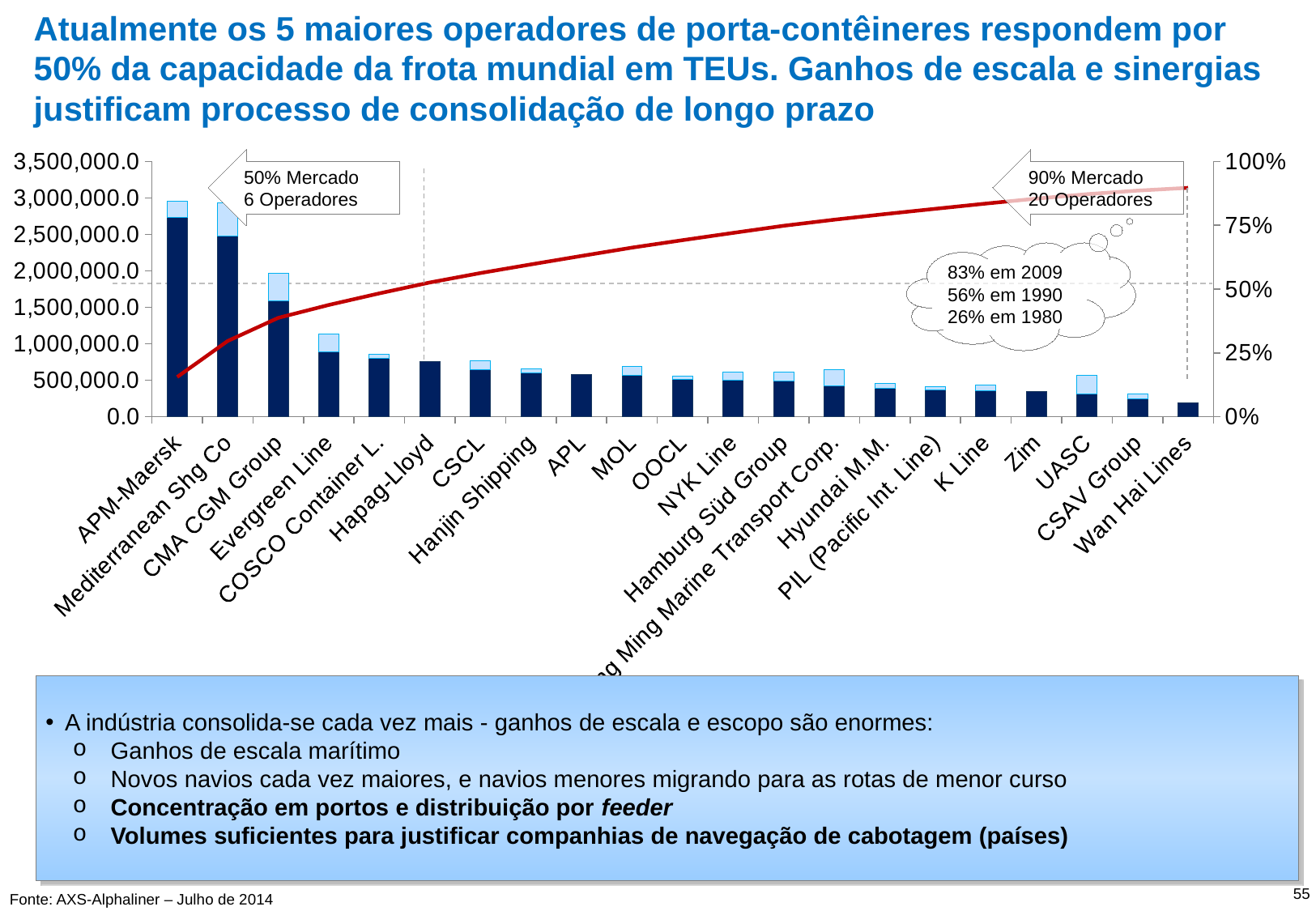
Does the red line rise or fall from left to right across the chart? Rises Which operator has the tallest bar in the chart? APM-Maersk How many operators are shown on the x axis of the chart? 21 Is the bar for APM-Maersk greater or less than 2,500,000.0? greater According to the annotation on the chart, how many operators account for 50% of the market? 6 Operadores Is the bar for Hapag-Lloyd greater or less than 1,000,000.0? less Is the bar for Wan Hai Lines greater or less than 500,000.0? less According to the annotation on the chart, how many operators account for 90% of the market? 20 Operadores Which operator has the shortest bar in the chart? Wan Hai Lines Which bar is taller, CMA CGM Group or Evergreen Line? CMA CGM Group What kind of chart is shown on the slide? Bar chart with a line